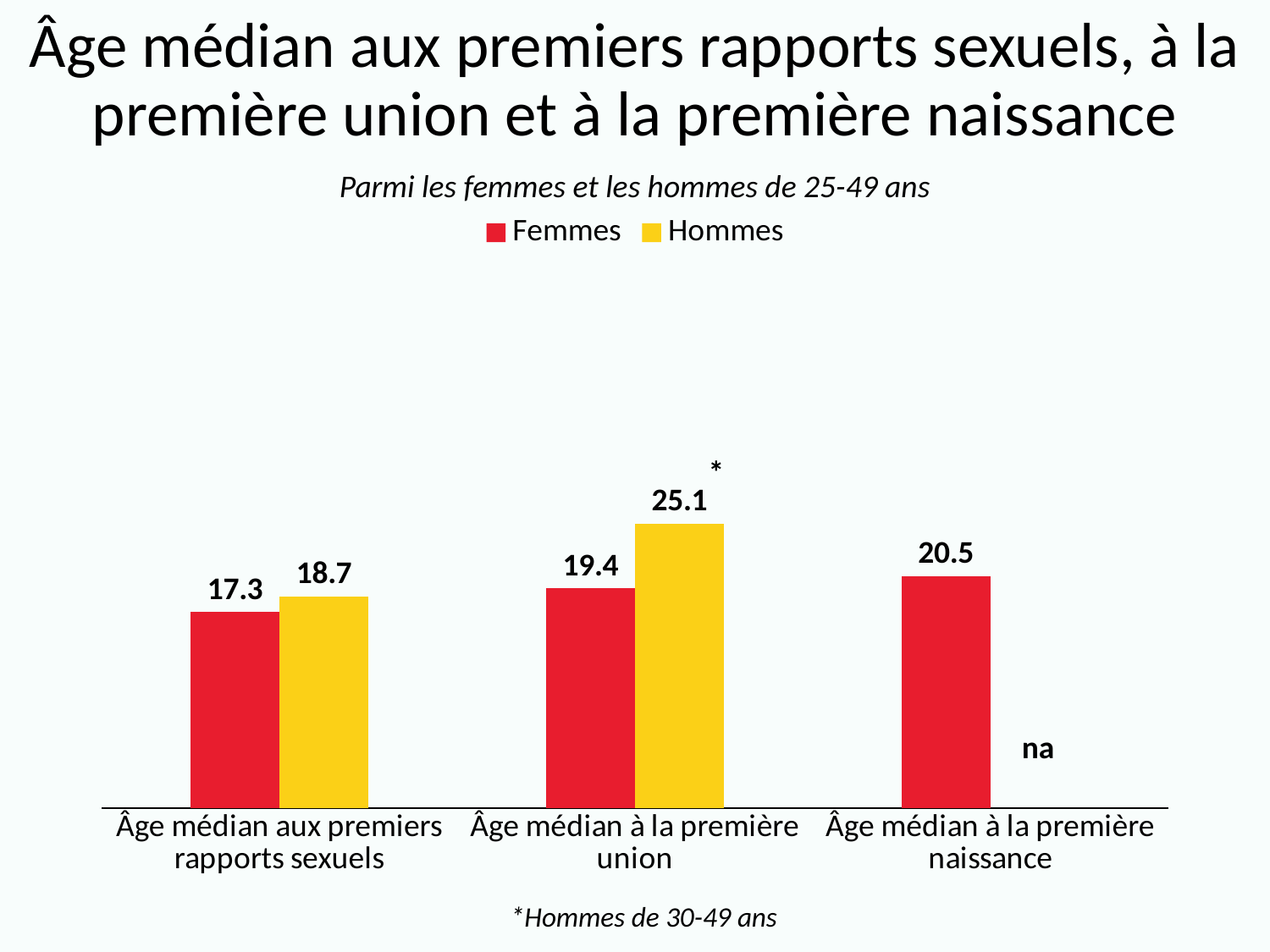
What kind of chart is shown on the slide? Bar chart Which category has the highest value for Femmes? Âge médian à la première naissance For 'Âge médian aux premiers rapports sexuels', which is larger, the Femmes value or the Hommes value? Hommes Which category has the lowest value for Femmes? Âge médian aux premiers rapports sexuels What is the median age at first birth for Femmes? 20.5 What is the median age at first union for Hommes? 25.1 How many categories are shown on the x axis? 3 What is the median age at first sexual intercourse for Femmes? 17.3 What is the difference between the Hommes and Femmes values for 'Âge médian à la première union'? 5.7 How many series does the legend list? 2 What is the median age at first sexual intercourse for Hommes? 18.7 What value is shown for Hommes in the 'Âge médian à la première naissance' category? na